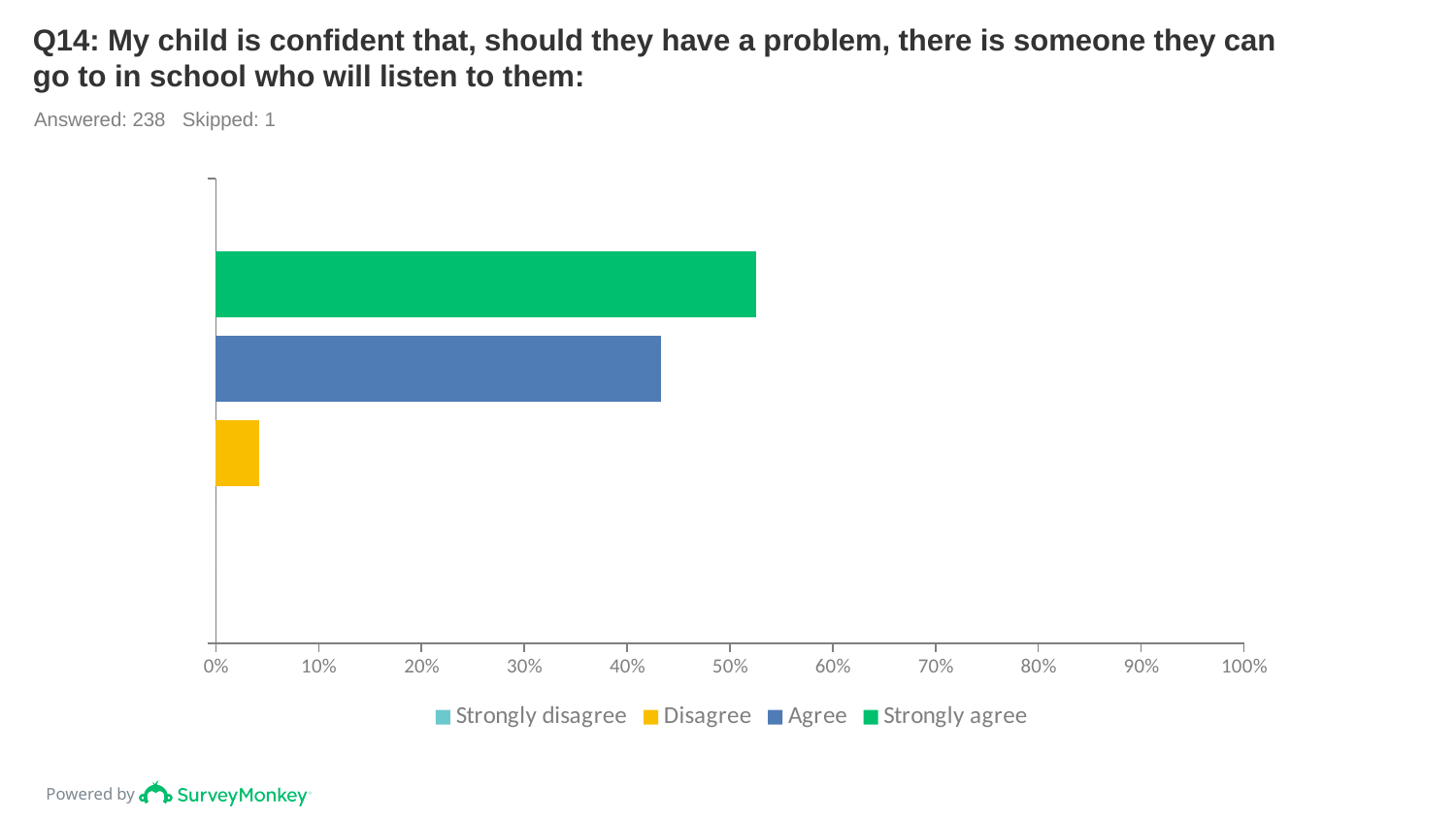
Is the value for Strongly agree greater or less than 50%? greater Which of the visible bars is the shortest? Disagree How many respondents answered this question according to the slide? 238 Is the value for Strongly agree greater or less than 60%? less Which is larger, the value for Agree or the value for Disagree? Agree Is the value for Disagree greater or less than 10%? less Which is larger, the value for Strongly agree or the value for Agree? Strongly agree How many response options does the legend list? 4 What colour is used for the Strongly agree bar? Green Which response option has the longest bar? Strongly agree What kind of chart is shown on the slide? Bar chart